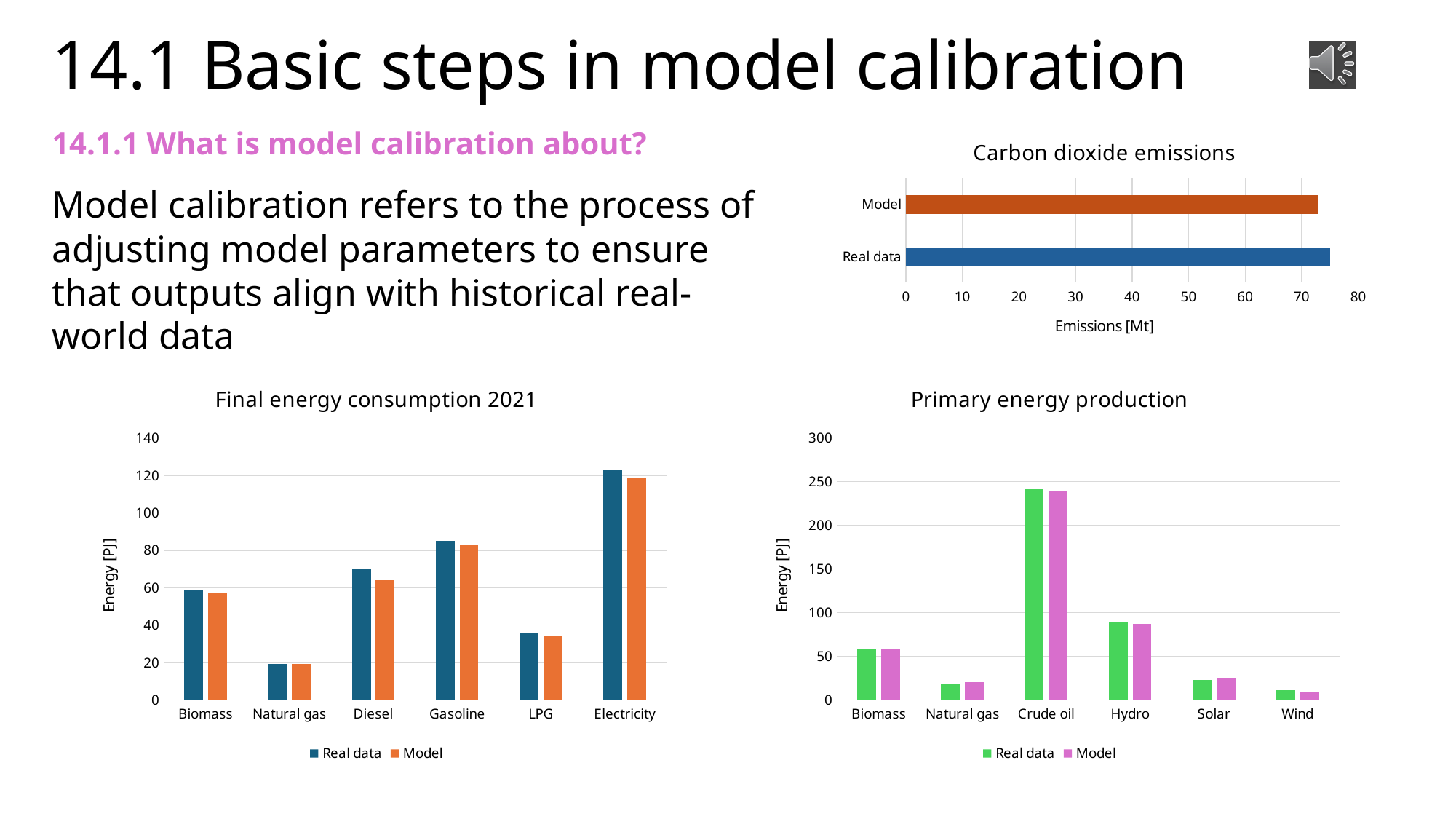
In the "Primary energy production" chart, is the Model value for Crude oil greater or less than 200? greater In the "Final energy consumption 2021" chart, which category has the lowest Model value? Natural gas How many series does the legend of the "Primary energy production" chart list? 2 In the "Carbon dioxide emissions" chart, what is the x-axis label? Emissions [Mt] In the "Primary energy production" chart, which category has the highest Real data value? Crude oil What type of chart is the "Carbon dioxide emissions" chart? bar chart In the "Carbon dioxide emissions" chart, is the value for Real data greater or less than 70? greater In the "Final energy consumption 2021" chart, which category has the highest Real data value? Electricity In the "Final energy consumption 2021" chart, how many categories are shown on the x axis? 6 In the "Final energy consumption 2021" chart, which is larger, the Real data value for Diesel or the Real data value for LPG? Diesel In the "Primary energy production" chart, which category has the lowest Model value? Wind In the "Final energy consumption 2021" chart, is the Real data value for Electricity greater or less than 120? greater